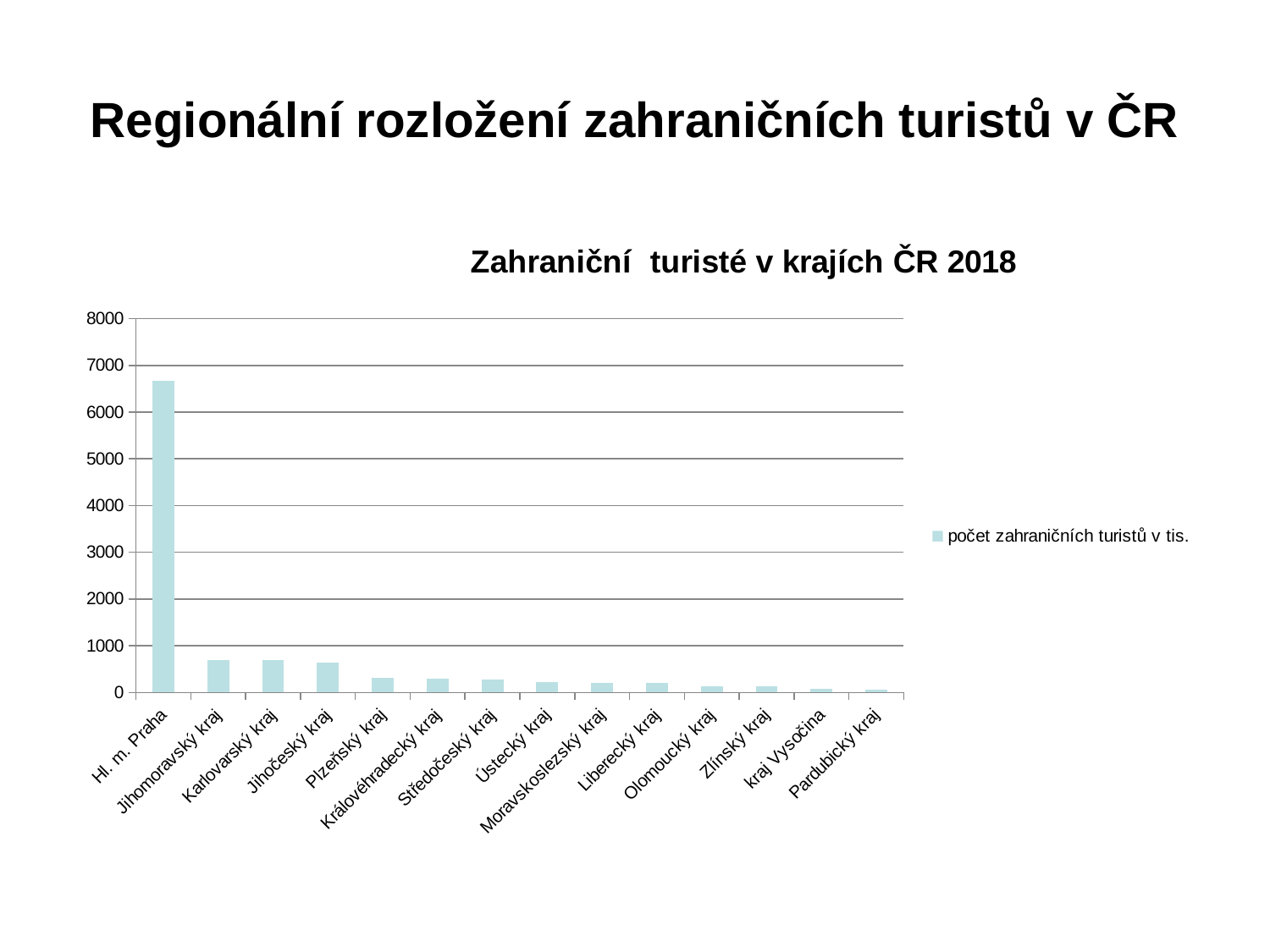
Which region has the highest number of foreign tourists? Hl. m. Praha Which is larger, the value for Jihočeský kraj or the value for Plzeňský kraj? Jihočeský kraj How many series does the legend list? 1 Which region has the lowest number of foreign tourists? Pardubický kraj Is the value for Hl. m. Praha greater or less than 6000? greater What is the title of the chart? Zahraniční turisté v krajích ČR 2018 Do the values generally rise or fall moving from left to right along the x axis? fall Is the value for Plzeňský kraj greater or less than 1000? less What is the legend entry for the plotted series? počet zahraničních turistů v tis. Is the value for Jihomoravský kraj greater or less than 1000? less How many regions (categories) are plotted on the x axis? 14 What kind of chart is shown on the slide? bar chart